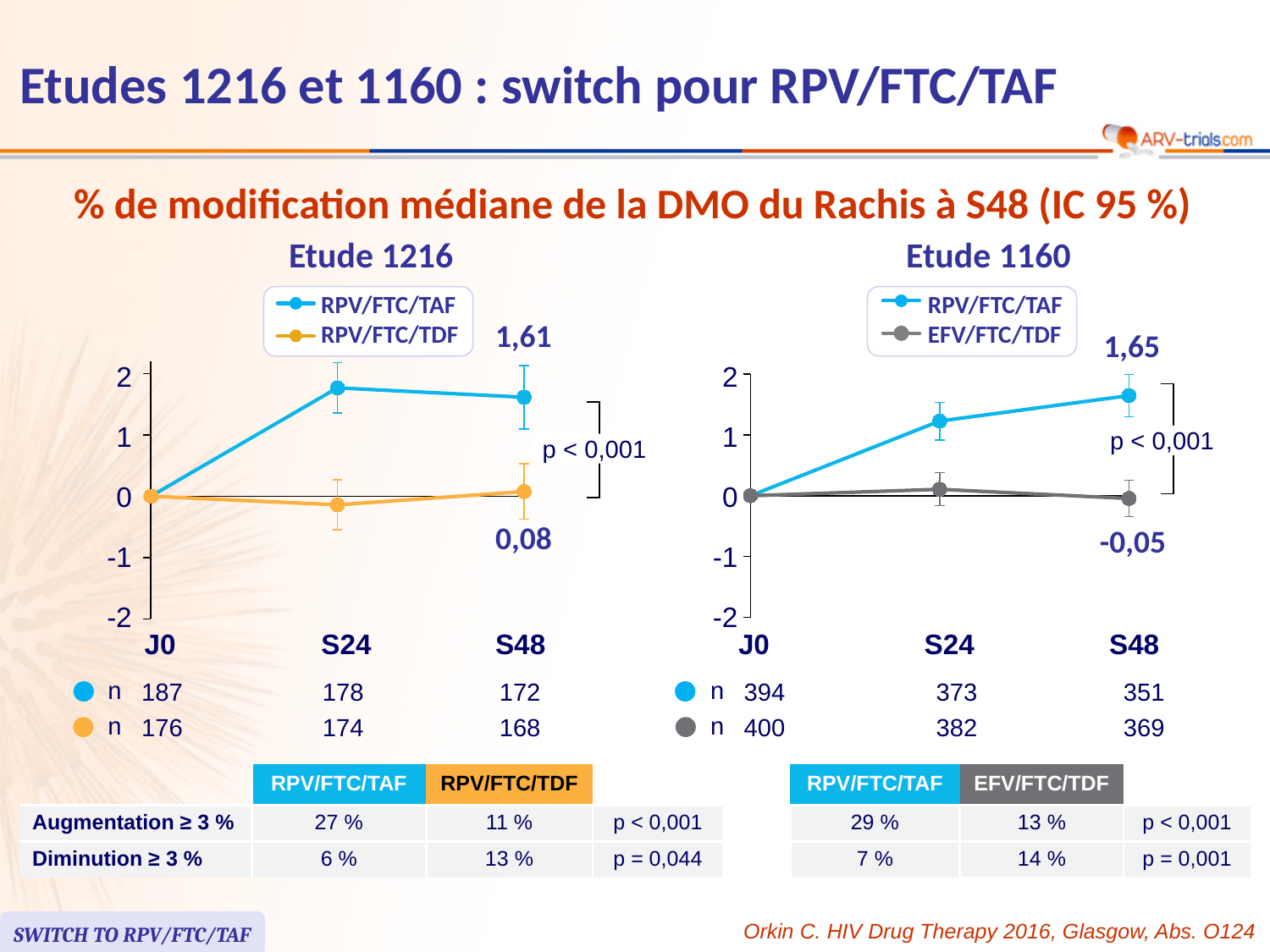
In the Etude 1216 chart, is the value for RPV/FTC/TAF at S24 greater or less than 1? greater How many series does the legend of the Etude 1216 chart list? 2 In the Etude 1216 chart, what is the difference between RPV/FTC/TAF and RPV/FTC/TDF at S48? 1,53 What kind of chart is used for Etude 1216? line chart In the Etude 1216 chart, what is the value for RPV/FTC/TDF at S48? 0,08 In the Etude 1160 chart, does the RPV/FTC/TAF line rise or fall from J0 to S48? rise How many time points are shown on the x axis of the Etude 1216 chart? 3 In the Etude 1160 chart, what is the difference between RPV/FTC/TAF and EFV/FTC/TDF at S48? 1,70 In the Etude 1216 chart, what is the value for RPV/FTC/TAF at S48? 1,61 In the Etude 1160 chart, which series has the higher value at S48, RPV/FTC/TAF or EFV/FTC/TDF? RPV/FTC/TAF In the Etude 1160 chart, what is the value for EFV/FTC/TDF at S48? -0,05 In the Etude 1160 chart, what is the value for RPV/FTC/TAF at S48? 1,65